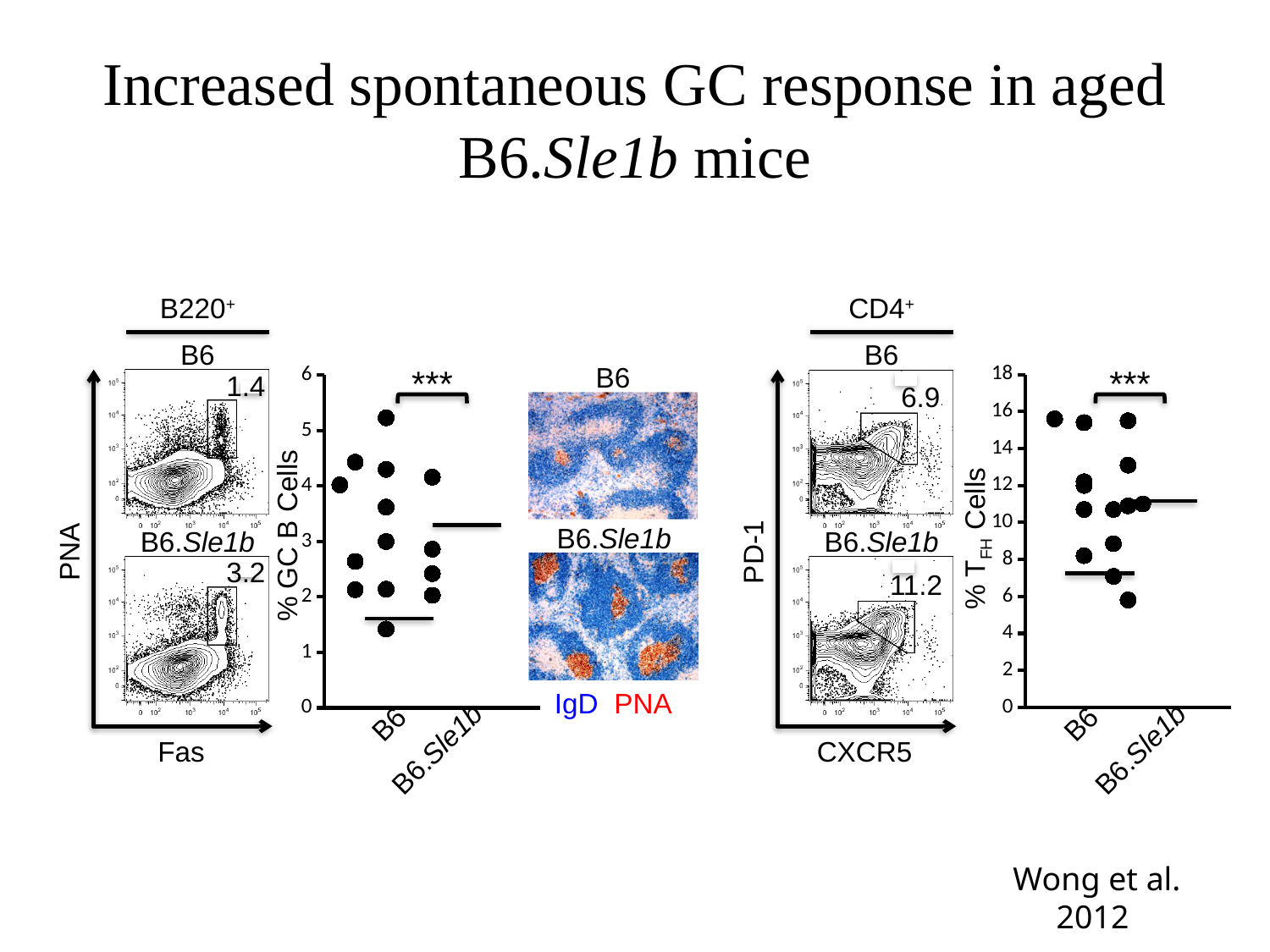
In the % GC B Cells chart, how many categories are shown on the x axis? 2 In the % TFH Cells chart, is the mean line for B6.Sle1b greater or less than 10? greater What kind of chart is the % GC B Cells chart? Dot plot (scatter plot) In the % GC B Cells chart, is the highest B6 point greater or less than 5? greater In the % GC B Cells chart, is the lowest B6 point greater or less than 2? less In the % TFH Cells chart, what is the maximum value shown on the y axis? 18 In the % GC B Cells chart, which group has the higher mean line, B6 or B6.Sle1b? B6.Sle1b In the % TFH Cells chart, what are the two categories on the x axis? B6 and B6.Sle1b